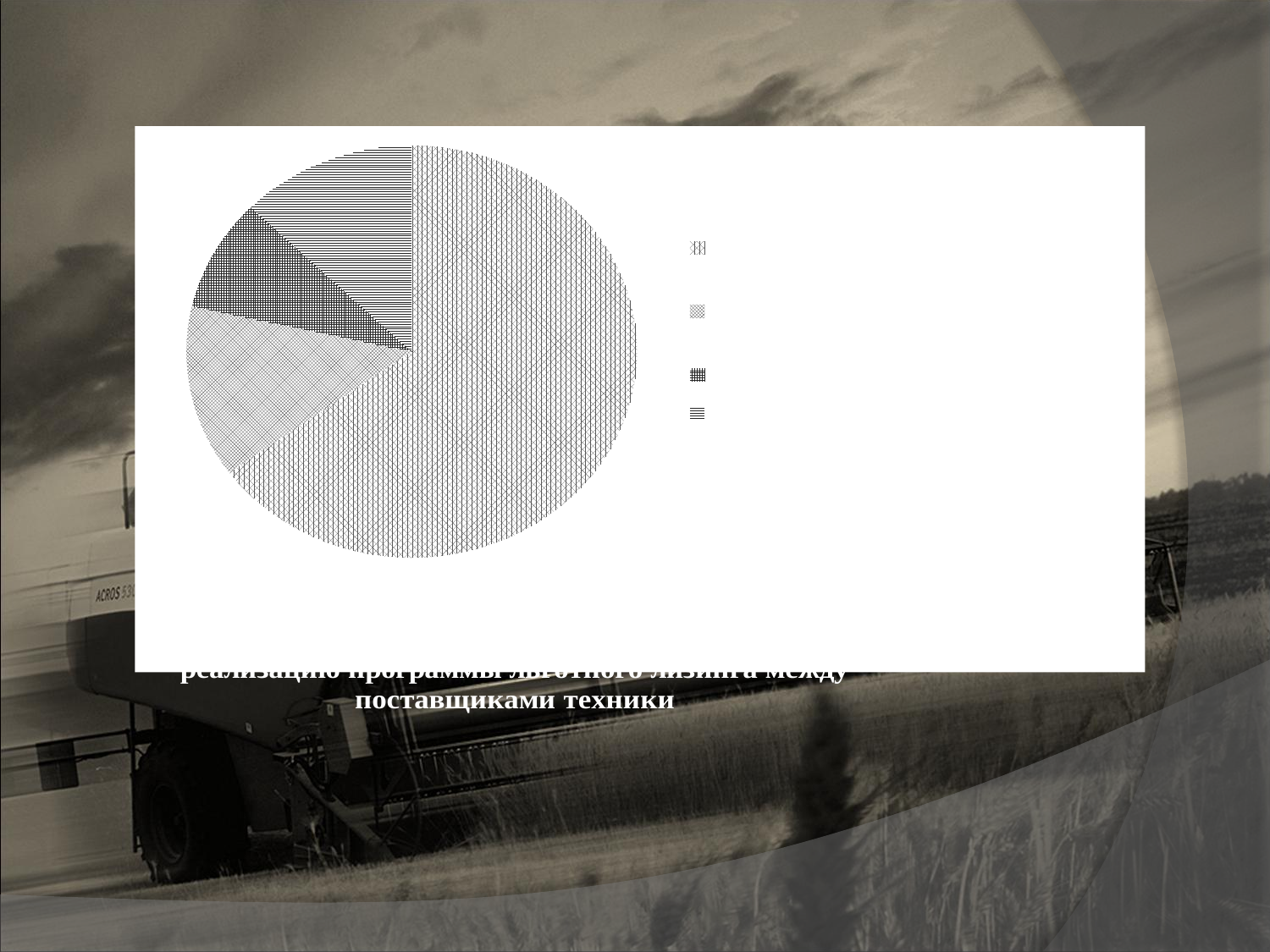
Are the slices of the pie chart filled with solid colours or with hatch patterns? hatch patterns What kind of chart is shown on the slide? pie chart How many slices does the pie chart have? 4 How many entries does the legend of the pie chart list? 4 Is the legend of the pie chart placed to the right or to the left of the pie? right Does the largest slice of the pie chart take up more or less than half of the pie? more